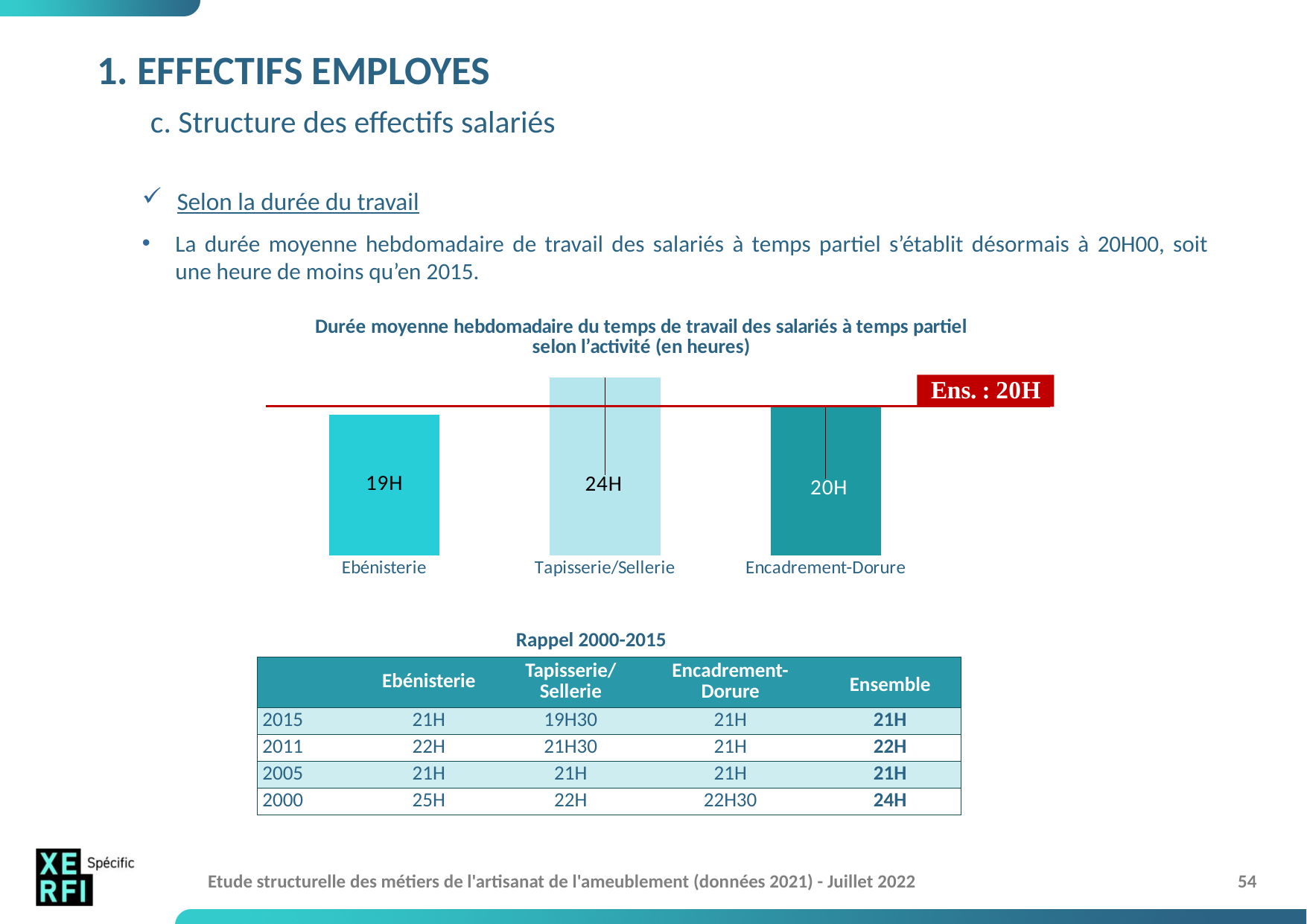
What is the average weekly working time for Encadrement-Dorure in the chart? 20H How many activities are shown as bars in the chart? 3 What is the title of the chart? Durée moyenne hebdomadaire du temps de travail des salariés à temps partiel selon l'activité (en heures) What is the average weekly working time for Ebénisterie in the chart? 19H What is the difference in hours between Tapisserie/Sellerie and Ebénisterie in the chart? 5H Which activity has the lowest average weekly working time in the chart? Ebénisterie What is the average weekly working time for Tapisserie/Sellerie in the chart? 24H What is the difference in hours between Encadrement-Dorure and Ebénisterie in the chart? 1H Which activity has the highest average weekly working time in the chart? Tapisserie/Sellerie Which is larger in the chart, the value for Ebénisterie or the value for Encadrement-Dorure? Encadrement-Dorure What overall (Ensemble) value is marked by the red line on the chart? 20H What kind of chart is used to show the average weekly working time by activity? Bar chart